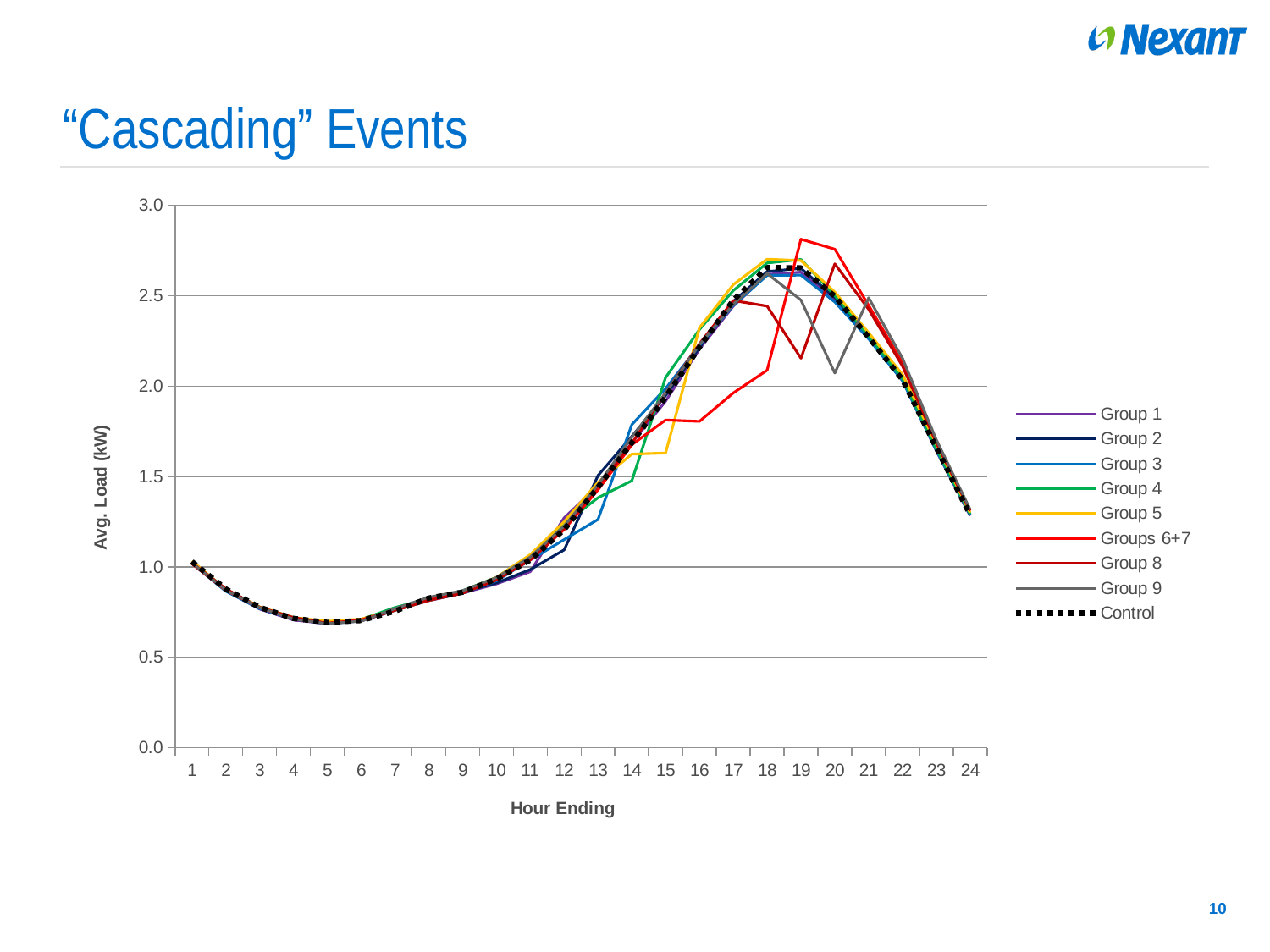
How many series does the legend list? 9 Is the Control value at hour ending 15 greater or less than 1.5? greater What is the title of the y axis? Avg. Load (kW) Do the Control values rise or fall from hour ending 19 to hour ending 24? fall Do the Control values rise or fall from hour ending 1 to hour ending 5? fall Is the Control value at hour ending 18 greater or less than 2.5? greater Is the Control value at hour ending 5 greater or less than 1.0? less How many hours are plotted along the x axis? 24 What is the title of the x axis? Hour Ending What kind of chart is shown on the slide? line chart